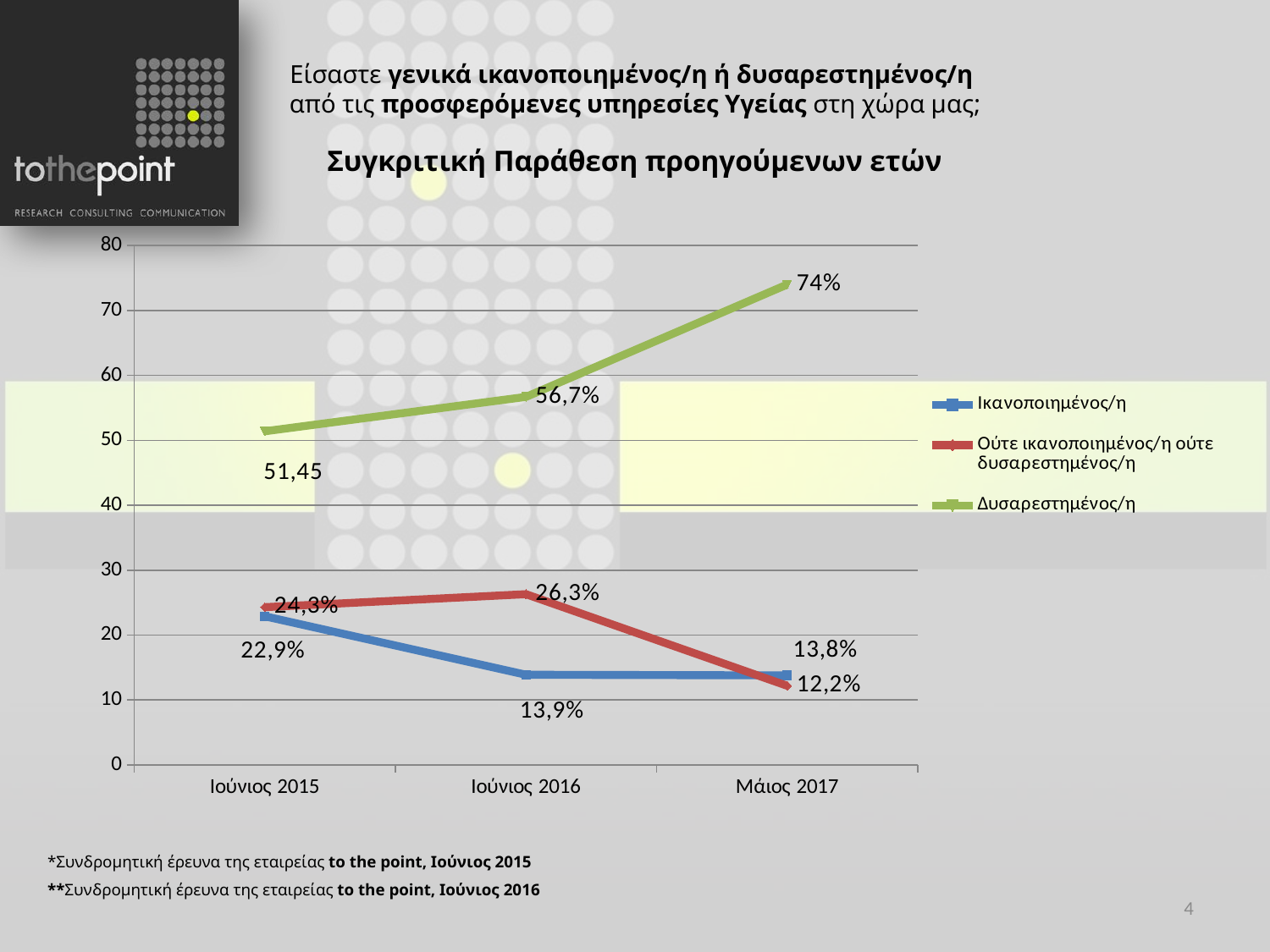
By how many percentage points did Δυσαρεστημένος/η increase from Ιούνιος 2016 to Μάιος 2017? 17,3 What is the value for Δυσαρεστημένος/η in Ιούνιος 2016? 56,7% What type of chart is shown on the slide? line chart Which series has the highest value in Μάιος 2017? Δυσαρεστημένος/η Is the value for Δυσαρεστημένος/η in Ιούνιος 2015 greater or less than 50? greater Which series has the lowest value in Ιούνιος 2016? Ικανοποιημένος/η What is the value for Ικανοποιημένος/η in Ιούνιος 2015? 22,9% How many time points are shown on the x axis? 3 What is the value for Δυσαρεστημένος/η in Μάιος 2017? 74% Does the Δυσαρεστημένος/η series rise or fall from Ιούνιος 2015 to Μάιος 2017? rise What is the value for Ούτε ικανοποιημένος/η ούτε δυσαρεστημένος/η in Ιούνιος 2016? 26,3% How many series does the legend list? 3